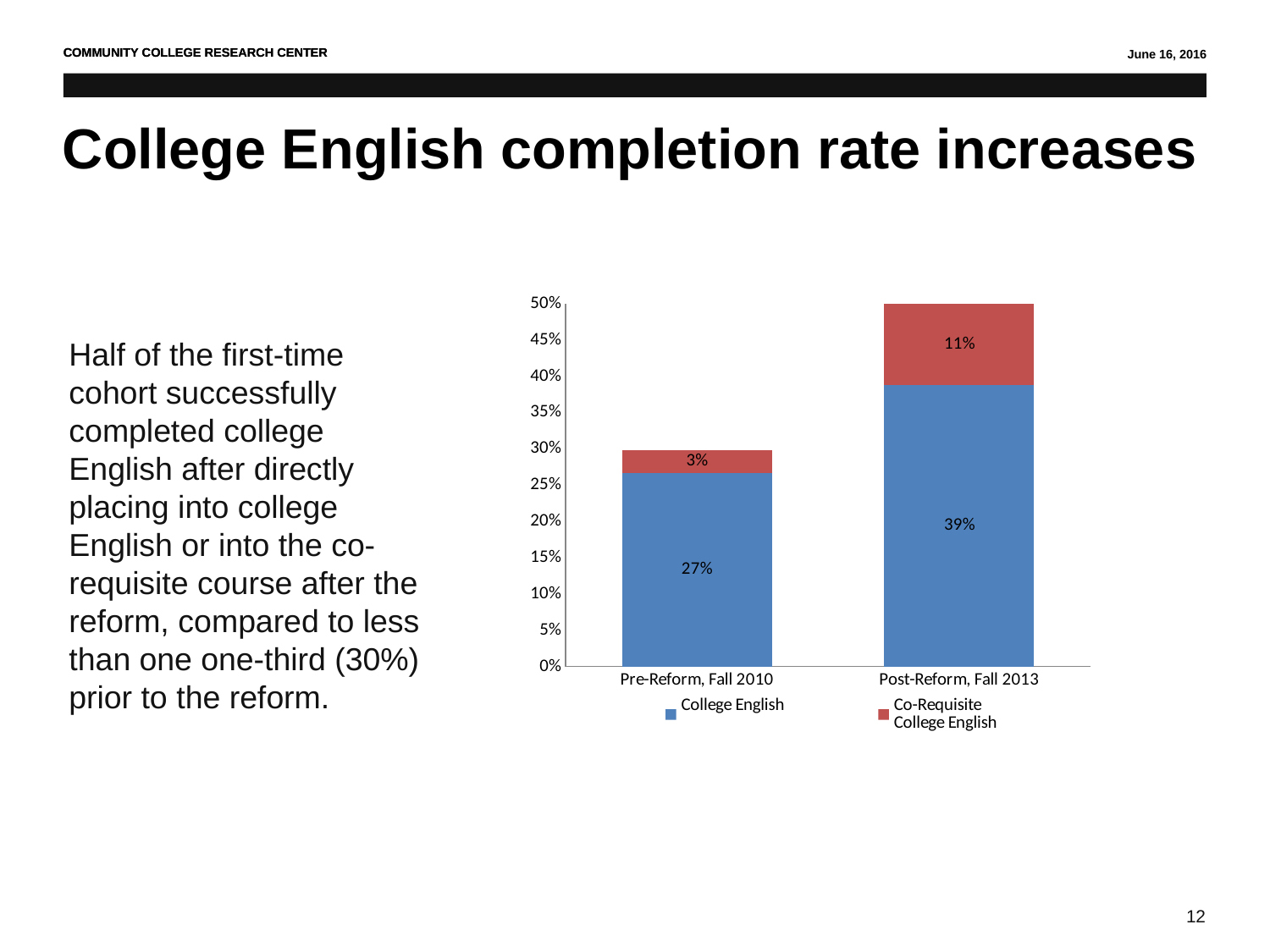
What is the College English value for Pre-Reform, Fall 2010? 27% What is the total of the stacked bar for Pre-Reform, Fall 2010? 30% What is the College English value for Post-Reform, Fall 2013? 39% What is the Co-Requisite College English value for Pre-Reform, Fall 2010? 3% Which category has the higher College English value? Post-Reform, Fall 2013 What kind of chart is shown on the slide? stacked bar chart What is the Co-Requisite College English value for Post-Reform, Fall 2013? 11% What is the total of the stacked bar for Post-Reform, Fall 2013? 50% Is the Co-Requisite College English value for Post-Reform, Fall 2013 larger or smaller than the Co-Requisite College English value for Pre-Reform, Fall 2010? larger How many series does the legend list? 2 What is the difference between the College English values for Post-Reform, Fall 2013 and Pre-Reform, Fall 2010? 12% How many categories are shown on the x axis? 2